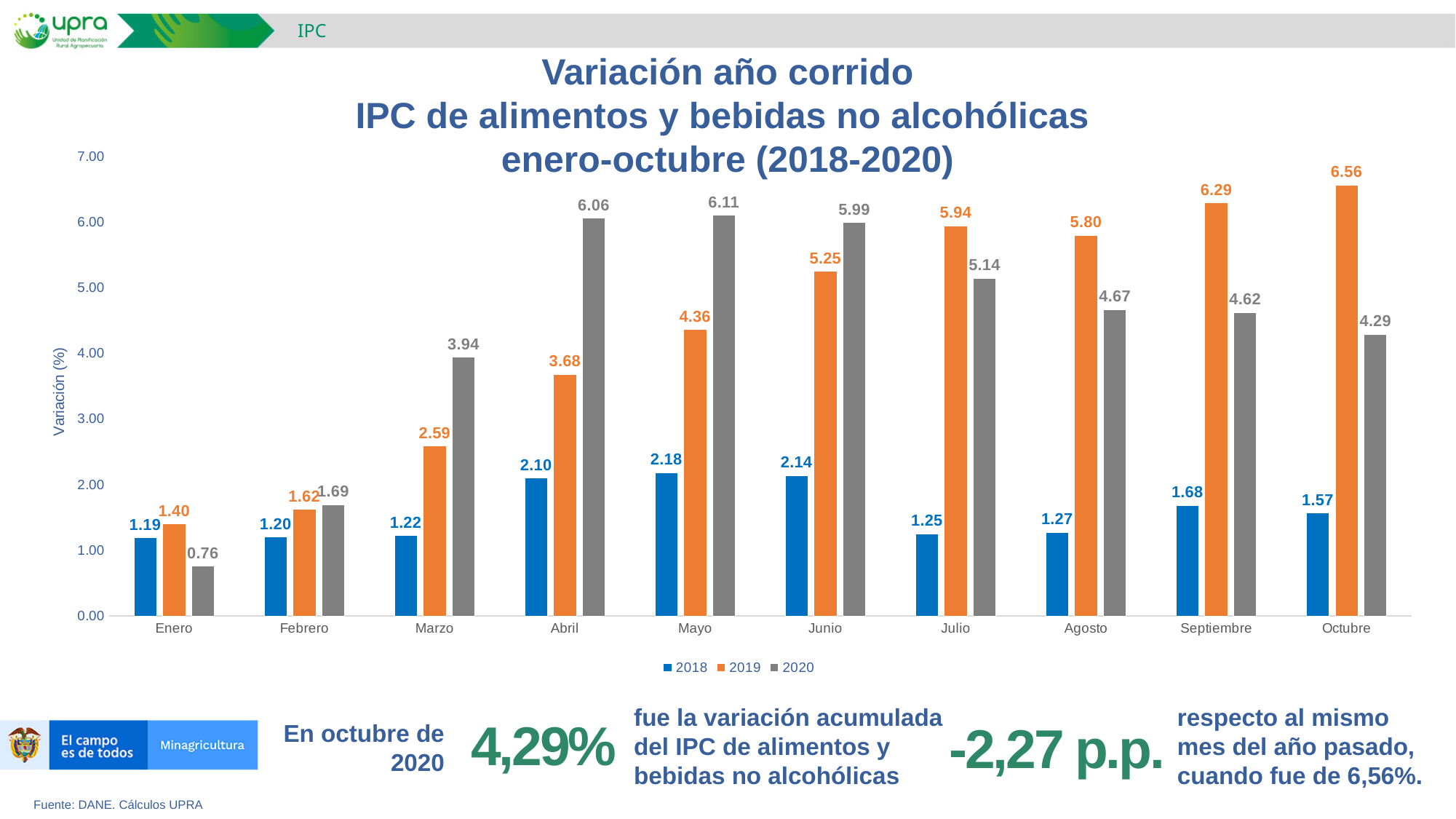
Does the 2019 series rise or fall from Enero to Octubre? Rise Which month has the lowest value for the 2020 series? Enero How many months are shown on the x axis? 10 Which month has the highest value for the 2019 series? Octubre What kind of chart is shown on the slide? Bar chart Which month has the highest value for the 2020 series? Mayo What is the value for 2020 in Octubre? 4.29 How many series does the legend list? 3 What is the difference between the 2019 and 2020 values in Octubre? 2.27 Which is larger in Abril, the 2019 value or the 2020 value? 2020 What is the value for 2018 in Septiembre? 1.68 What is the value for 2019 in Mayo? 4.36